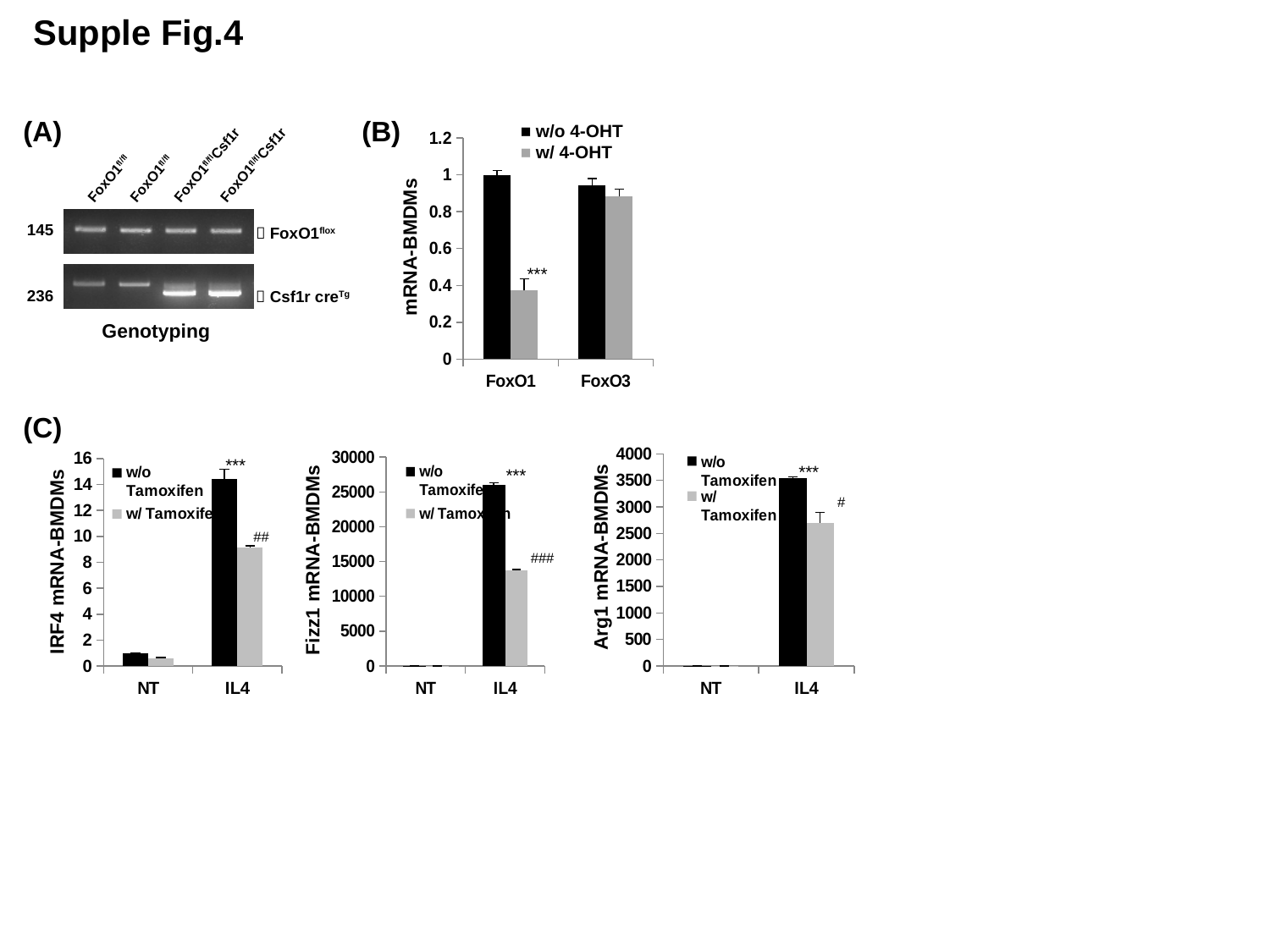
In the panel (B) chart, is the value for FoxO3 with 4-OHT (w/ 4-OHT) greater or less than 0.6? greater What kind of chart is the IRF4 mRNA-BMDMs chart in panel (C)? bar chart In the Arg1 mRNA-BMDMs chart in panel (C), is the value for IL4 with Tamoxifen greater or less than 3000? less In the panel (B) chart, how many series does the legend list? 2 In the Fizz1 mRNA-BMDMs chart in panel (C), is the value for IL4 without Tamoxifen greater or less than 20000? greater In the panel (B) chart, what is the y-axis label? mRNA-BMDMs In the panel (B) chart, which is larger for FoxO1: the w/o 4-OHT bar or the w/ 4-OHT bar? w/o 4-OHT In the Arg1 mRNA-BMDMs chart in panel (C), which category has the highest bar? IL4